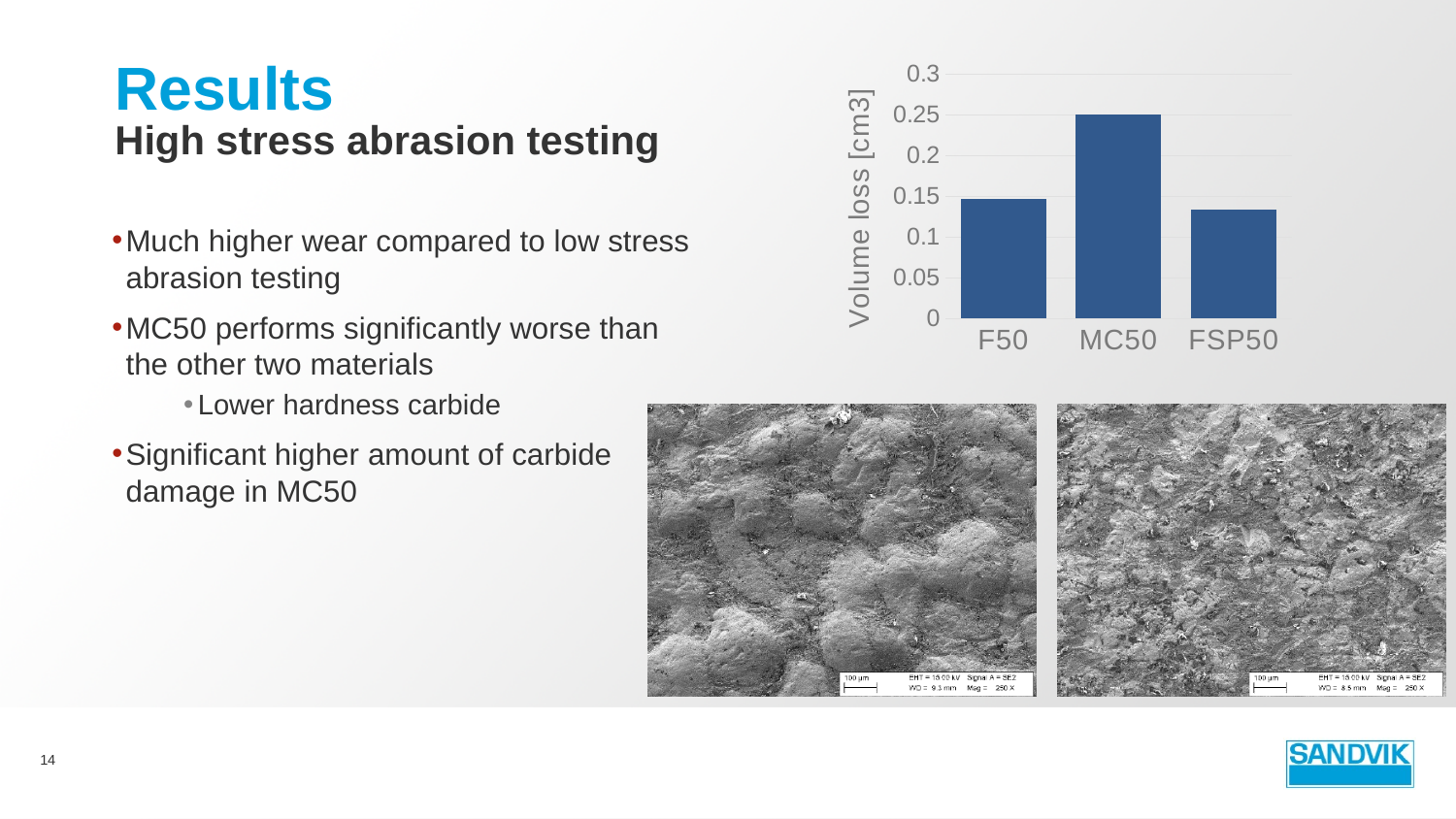
How many materials (categories) are plotted in the chart? 3 What is the highest value shown on the vertical axis of the chart? 0.3 Which material has the highest volume loss in the chart? MC50 Is the volume loss for FSP50 greater or less than 0.1? greater Is the volume loss for F50 greater or less than 0.1? greater Which has a larger volume loss, MC50 or FSP50? MC50 Is the volume loss for MC50 greater or less than 0.2? greater What kind of chart is shown on the slide? bar chart Which material has the lowest volume loss in the chart? FSP50 What is the label of the vertical axis of the chart? Volume loss [cm3] Which has a larger volume loss, MC50 or F50? MC50